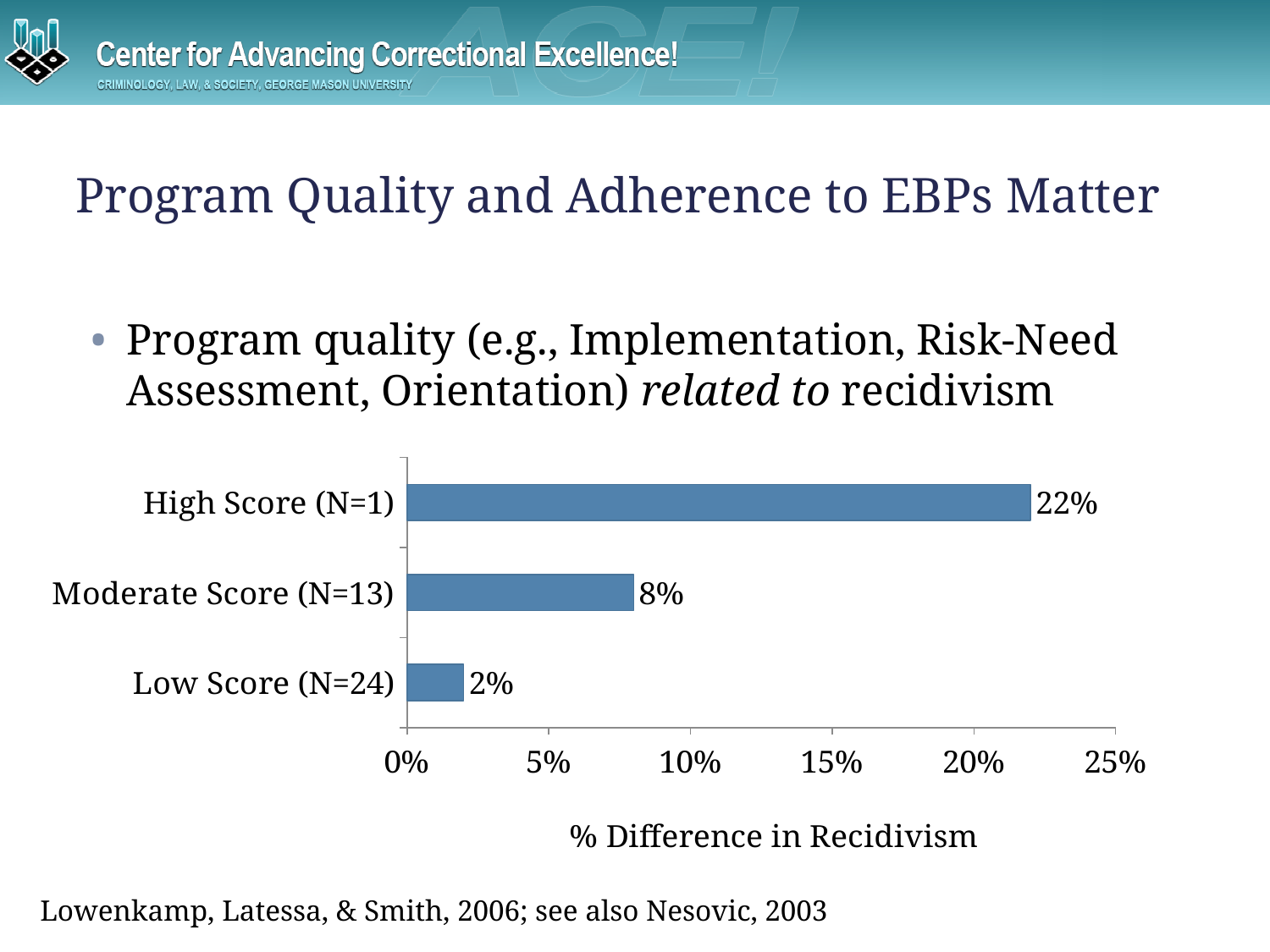
What is the difference between the High Score (N=1) and Moderate Score (N=13) values? 14% Is the value for High Score (N=1) greater or less than 20%? greater What is the label of the horizontal axis of the chart? % Difference in Recidivism What is the % difference in recidivism for Moderate Score (N=13)? 8% What kind of chart is shown on the slide? bar chart Which category has the highest % difference in recidivism? High Score (N=1) Which is larger, the value for Moderate Score (N=13) or Low Score (N=24)? Moderate Score (N=13) What is the % difference in recidivism for Low Score (N=24)? 2% What is the % difference in recidivism for High Score (N=1)? 22% What is the difference between the Moderate Score (N=13) and Low Score (N=24) values? 6% Which category has the lowest % difference in recidivism? Low Score (N=24) How many categories are shown in the chart? 3